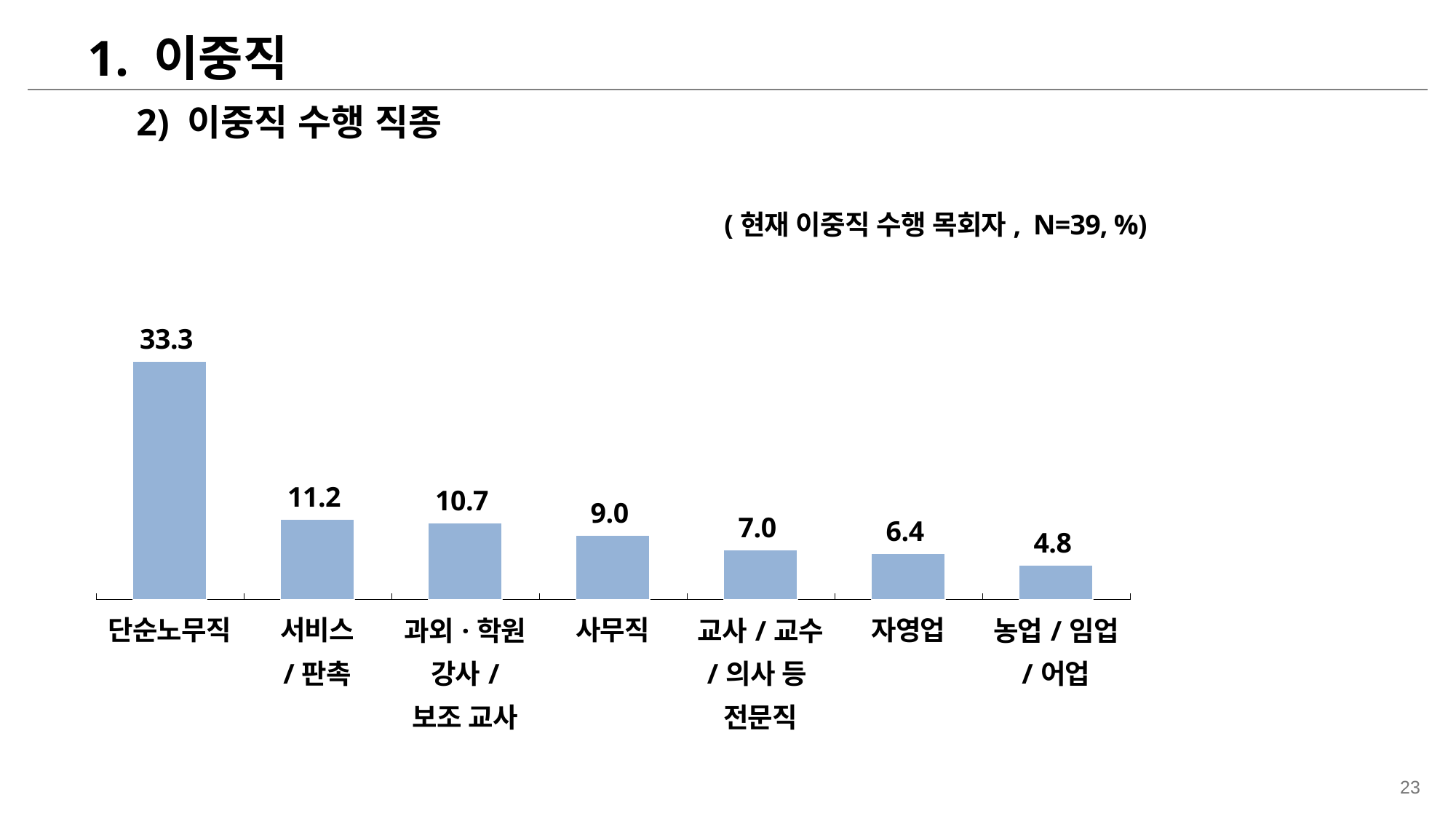
What kind of chart is shown on the slide? bar chart What is the difference between the values for 교사 / 교수 / 의사 등 전문직 and 자영업? 0.6 Which category has the lowest value? 농업 / 임업 / 어업 What is the value for 사무직? 9.0 What is the value for 단순노무직? 33.3 What is the value for 농업 / 임업 / 어업? 4.8 Which category has the highest value? 단순노무직 What is the difference between the values for 단순노무직 and 서비스 / 판촉? 22.1 Do the values rise or fall from left to right along the x axis? fall What is the value for 서비스 / 판촉? 11.2 How many categories are shown in the chart? 7 Which is larger, the value for 과외 · 학원 강사 / 보조 교사 or the value for 사무직? 과외 · 학원 강사 / 보조 교사